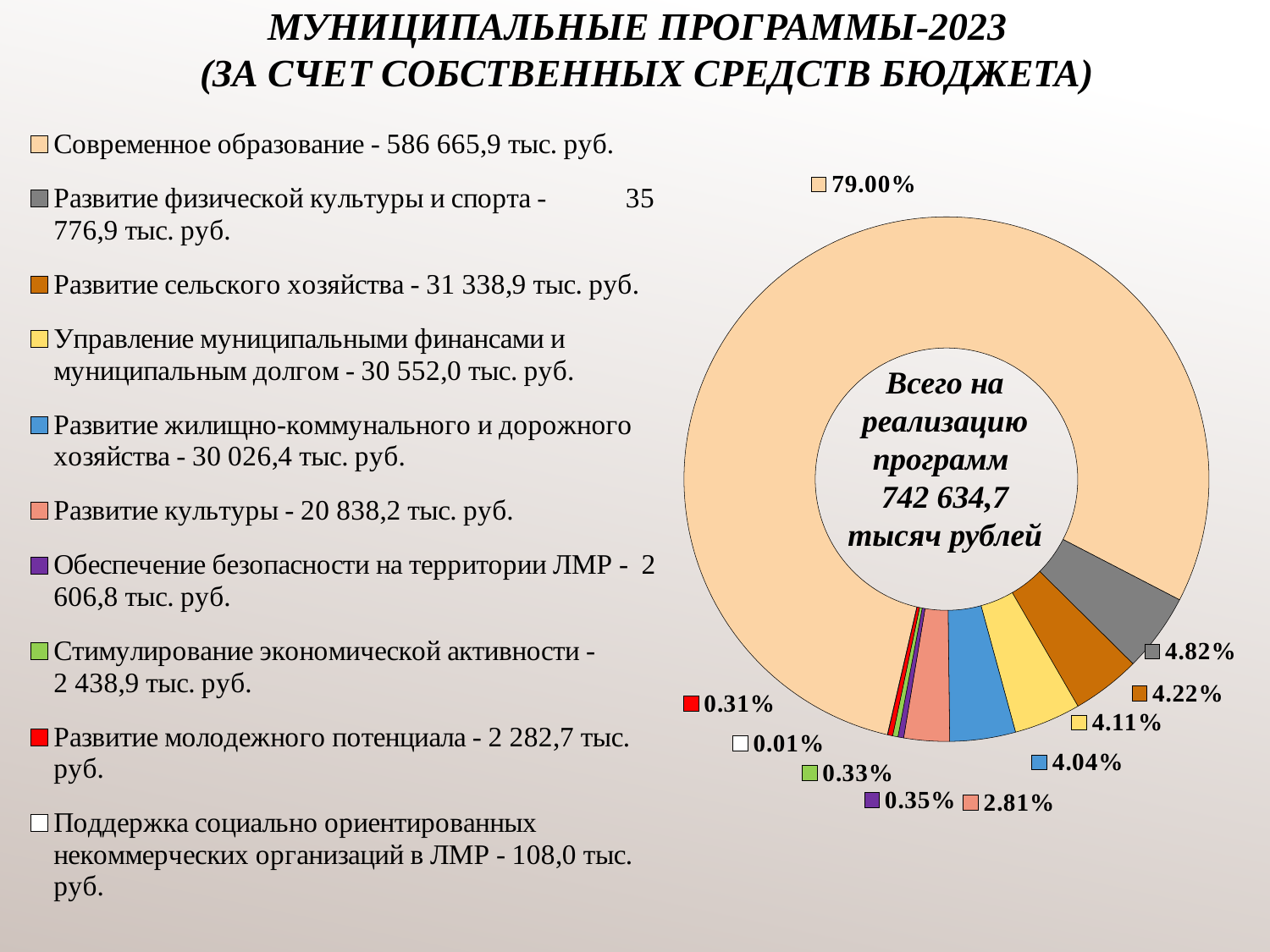
What percentage is shown for "Развитие культуры" (salmon slice)? 2.81% Which category has the largest share of the chart? Современное образование What kind of chart is shown on the slide? Doughnut (pie) chart What percentage is shown for "Развитие физической культуры и спорта" (gray slice)? 4.82% What share of the chart does "Современное образование" take? 79.00% Which is larger: the share for "Управление муниципальными финансами и муниципальным долгом" or the share for "Развитие жилищно-коммунального и дорожного хозяйства"? Управление муниципальными финансами и муниципальным долгом Which category has the smallest share of the chart? Поддержка социально ориентированных некоммерческих организаций в ЛМР What is the difference in percentage points between the gray slice (4.82%) and the blue slice (4.04%)? 0.78% What percentage is shown for "Развитие сельского хозяйства" (brown slice)? 4.22% What total amount for implementing the programs is printed in the centre of the chart? 742 634,7 тысяч рублей How many categories does the legend list? 10 What amount does the legend give for "Развитие молодежного потенциала"? 2 282,7 тыс. руб.